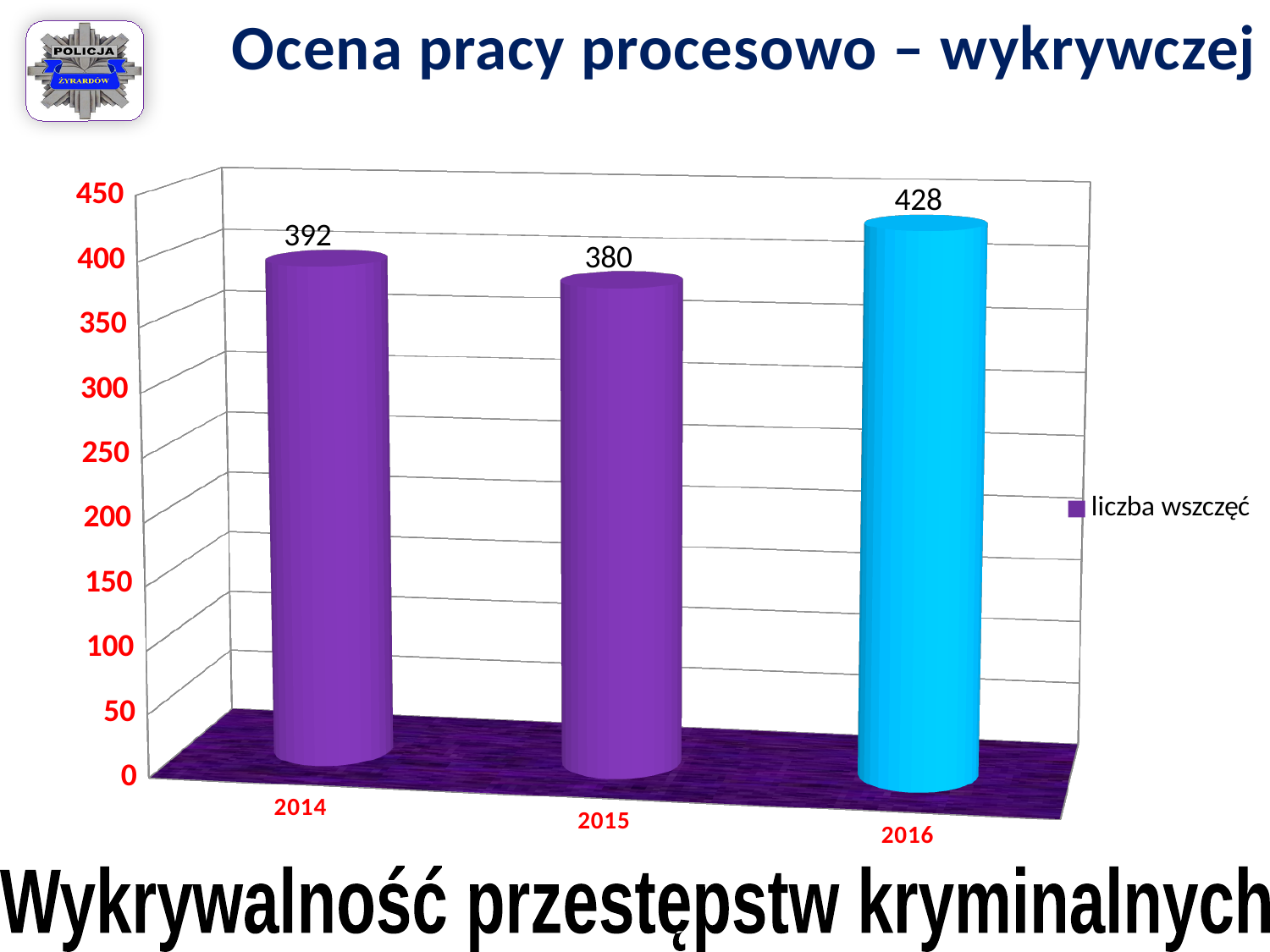
What is the legend entry shown on the chart? liczba wszczęć How many years are shown on the x axis? 3 What is the value for 2016? 428 What kind of chart is shown on the slide? bar chart Which is larger, the value for 2014 or the value for 2016? 2016 Which year has the highest value? 2016 What is the value for 2014? 392 What is the difference between the values for 2014 and 2015? 12 What is the difference between the values for 2016 and 2015? 48 What is the value for 2015? 380 Is the value for 2015 greater or less than 400? less Which year has the lowest value? 2015